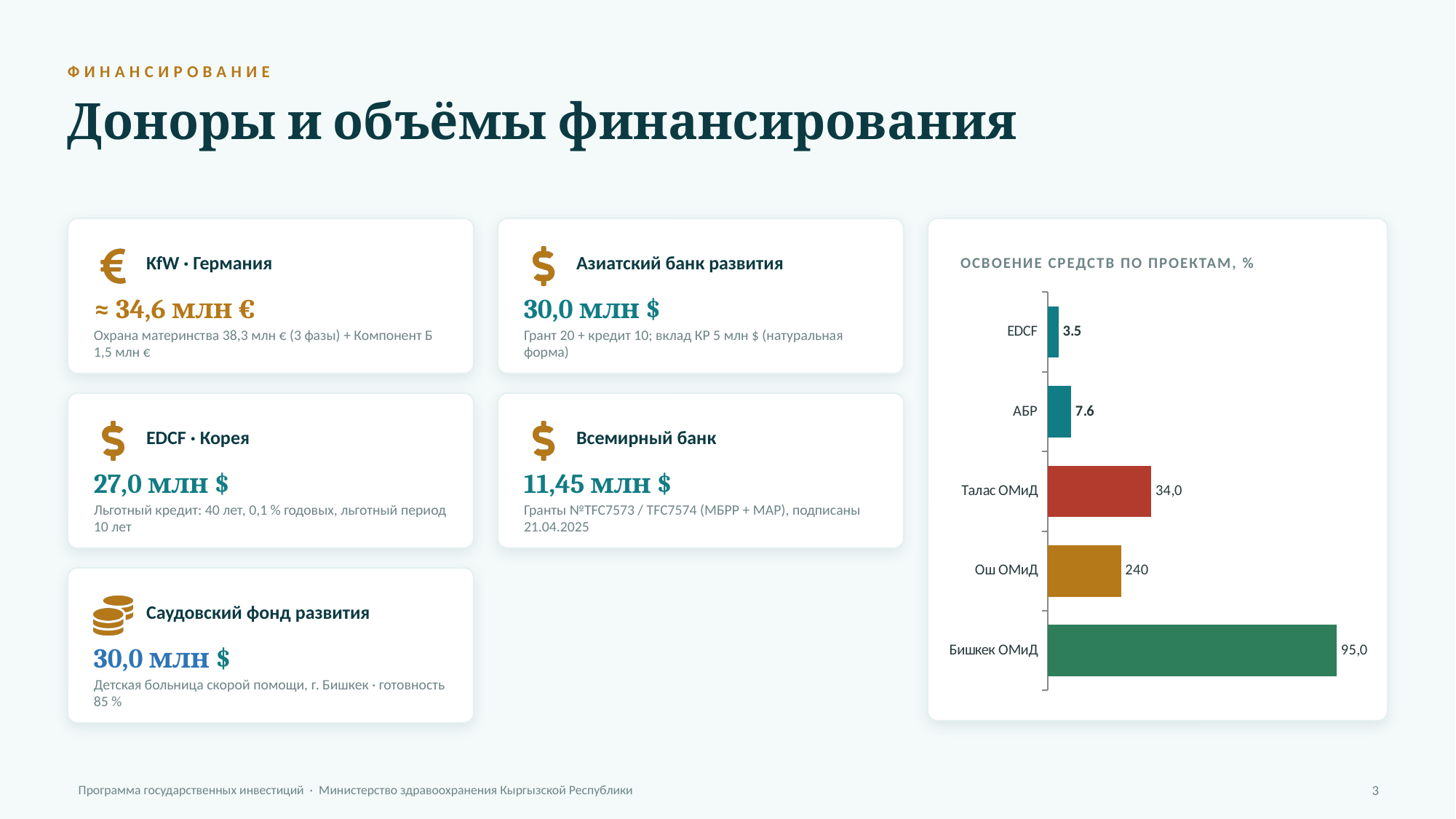
What is the value for EDCF in the chart "ОСВОЕНИЕ СРЕДСТВ ПО ПРОЕКТАМ, %"? 3.5 What is the title of the chart on the slide? ОСВОЕНИЕ СРЕДСТВ ПО ПРОЕКТАМ, % Which is larger, the value for Талас ОМиД or the value for АБР? Талас ОМиД Which category has the lowest value in the chart? EDCF What is the difference between the values for АБР and EDCF? 4.1 What kind of chart is shown on the slide? bar chart What is the value for Бишкек ОМиД in the chart? 95,0 What value is printed next to the bar for Ош ОМиД? 240 How many categories are shown in the chart? 5 What is the value for Талас ОМиД in the chart? 34,0 What is the value for АБР in the chart? 7.6 What is the difference between the values for Бишкек ОМиД and Талас ОМиД? 61,0